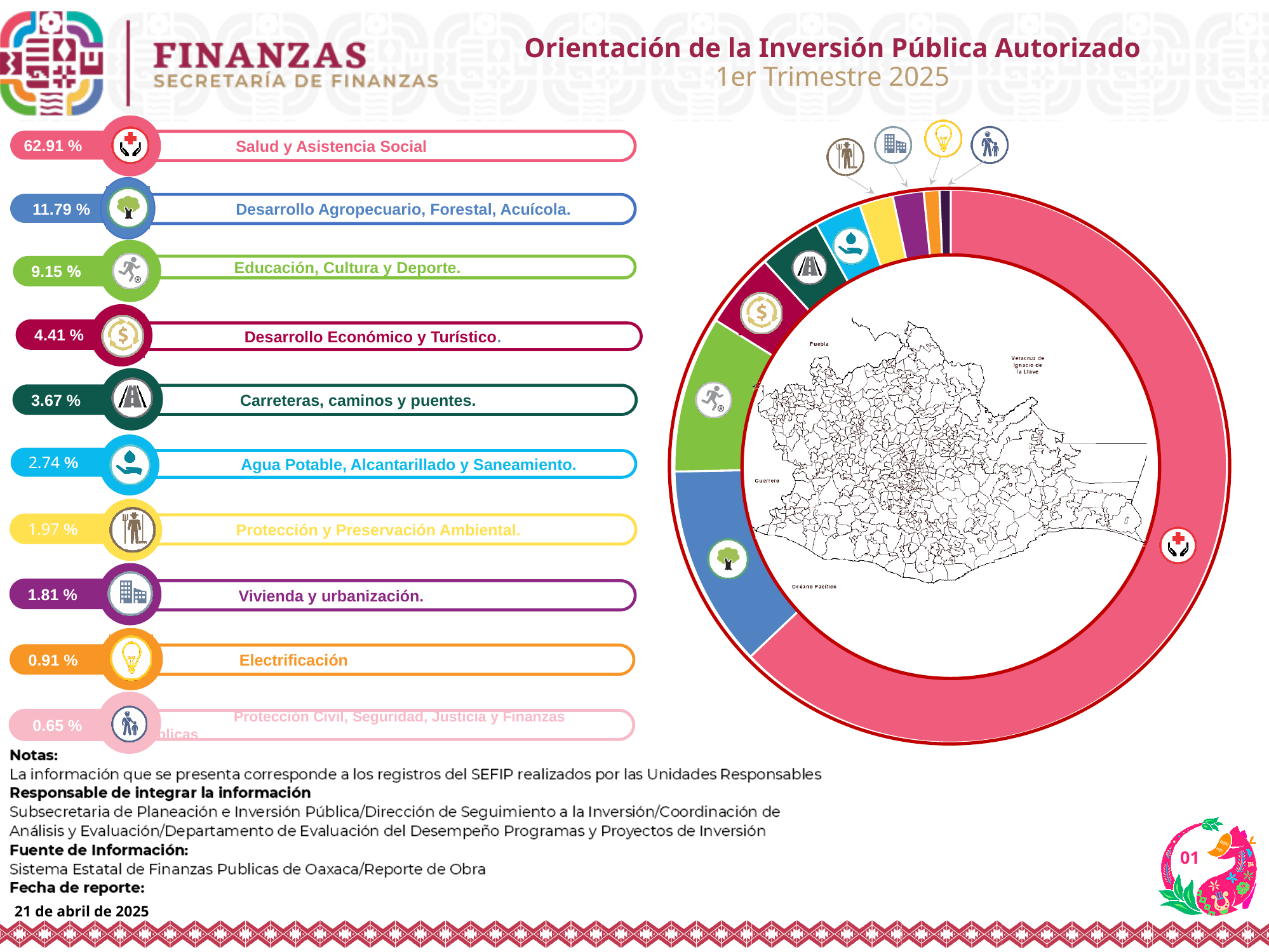
How many categories are shown in the chart? 10 What is the share for Carreteras, caminos y puentes? 3.67 % What kind of chart is shown on the slide? Pie (donut) chart What is the difference between the shares of Salud y Asistencia Social and Desarrollo Agropecuario, Forestal, Acuícola? 51.12 % Which category has the largest share? Salud y Asistencia Social Which has a larger share, Educación, Cultura y Deporte or Desarrollo Económico y Turístico? Educación, Cultura y Deporte What is the share for Electrificación? 0.91 % What colour is the slice for Salud y Asistencia Social in the donut chart? Pink What is the share for Salud y Asistencia Social? 62.91 % What is the share for Desarrollo Agropecuario, Forestal, Acuícola? 11.79 % Which category has the smallest share? Protección Civil, Seguridad, Justicia y Finanzas Públicas What is the title of the chart on the slide? Orientación de la Inversión Pública Autorizado